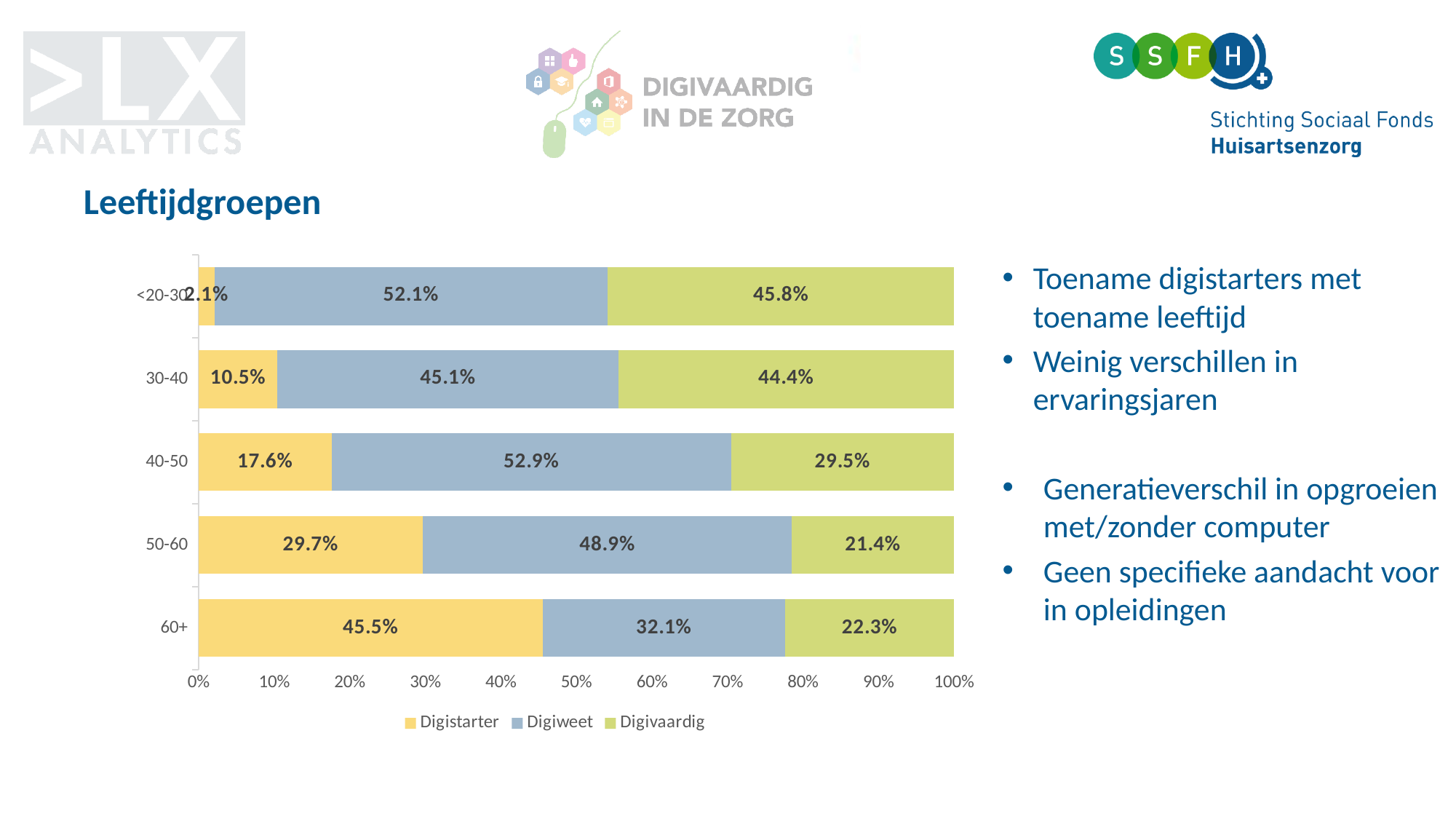
What is the title of the chart? Leeftijdgroepen How many series does the legend list? 3 Which age group has the highest Digistarter value? 60+ What is the Digivaardig value for the 30-40 age group? 44.4% What is the Digiweet value for the 50-60 age group? 48.9% Which age group has the lowest Digivaardig value? 50-60 What is the Digistarter value for the 60+ age group? 45.5% How many age groups are shown on the chart? 5 What is the difference between the Digistarter values for 50-60 and 40-50? 12.1% Which is larger, the Digiweet value for 40-50 or for 60+? 40-50 What kind of chart is shown on the slide? Stacked bar chart Is the Digistarter value for the 50-60 age group greater or less than 20%? greater